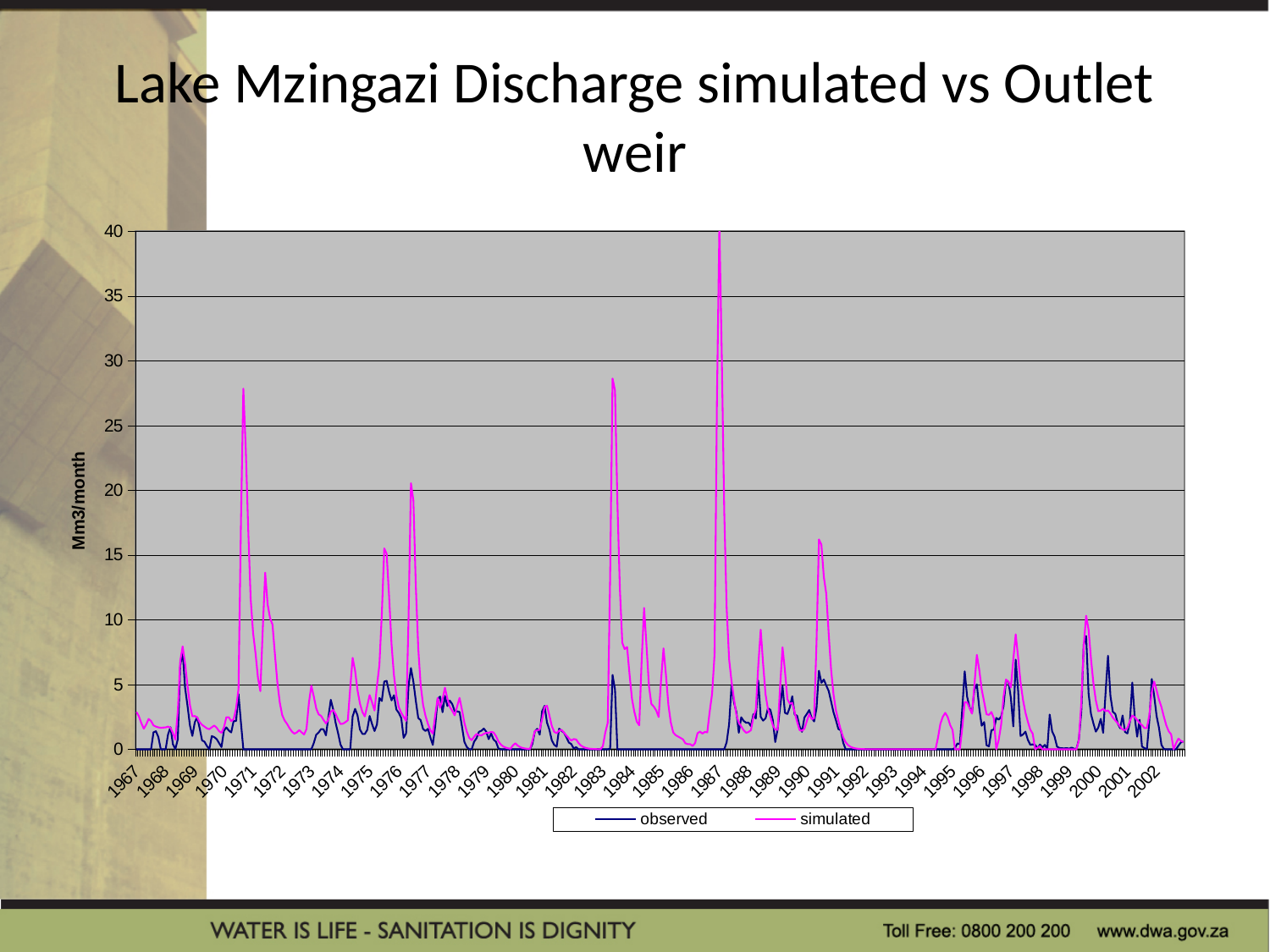
Is the highest value of the observed series greater or less than 10? less Which series reaches higher values overall, observed or simulated? simulated Is the simulated peak around 1971 greater or less than 25? greater Is the simulated peak around 1983 greater or less than 25? greater What is the label on the vertical axis? Mm3/month What kind of chart is shown on the slide? line chart In which year does the simulated series reach its highest peak? 1987 How many year labels are shown along the x axis? 36 What are the two series named in the legend? observed and simulated How many series does the legend list? 2